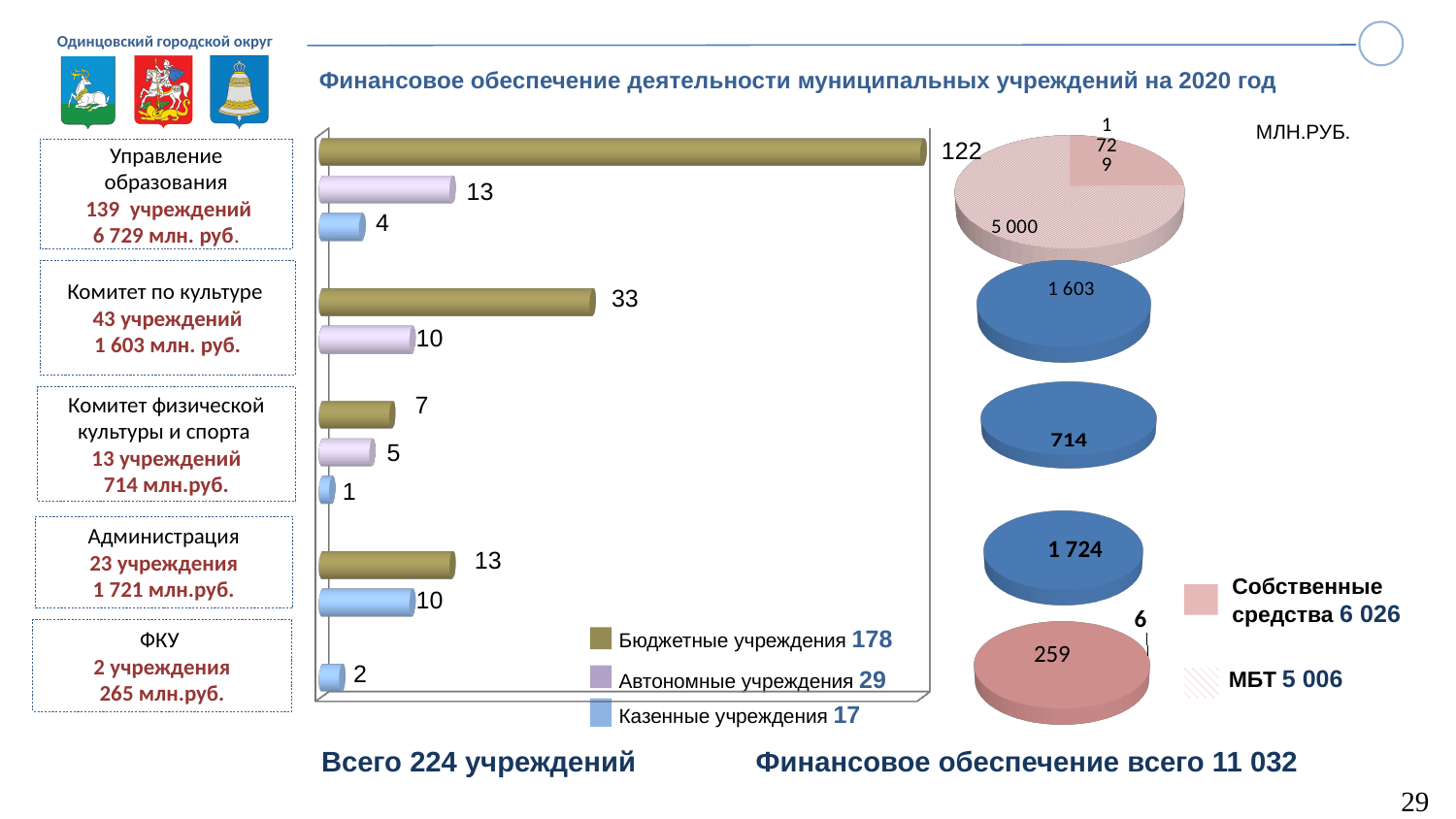
In the bar chart, what is the difference between the Бюджетные учреждения bar for Управление образования and the one for Комитет по культуре? 89 How many series does the bar chart legend list? 3 In the bar chart, what is the value of the Автономные учреждения bar for Комитет по культуре? 10 In the bar chart, what is the value of the Казенные учреждения bar for Комитет физической культуры и спорта? 1 In the pie chart for Комитет по культуре (second pie from the top), what value is shown? 1 603 In the bar chart, what is the value of the Казенные учреждения bar for ФКУ? 2 In the bar chart, which group has the longest Бюджетные учреждения bar? Управление образования In the bar chart, what is the value of the Бюджетные учреждения bar for Управление образования? 122 What type of chart is used on the left side of the slide? Bar chart In the bar chart legend, what total is shown next to Бюджетные учреждения? 178 In the bottom pie chart (ФКУ), what is the value of the larger slice? 259 In the bar chart, which is larger for Администрация: the Бюджетные учреждения bar or the Автономные учреждения bar? Бюджетные учреждения